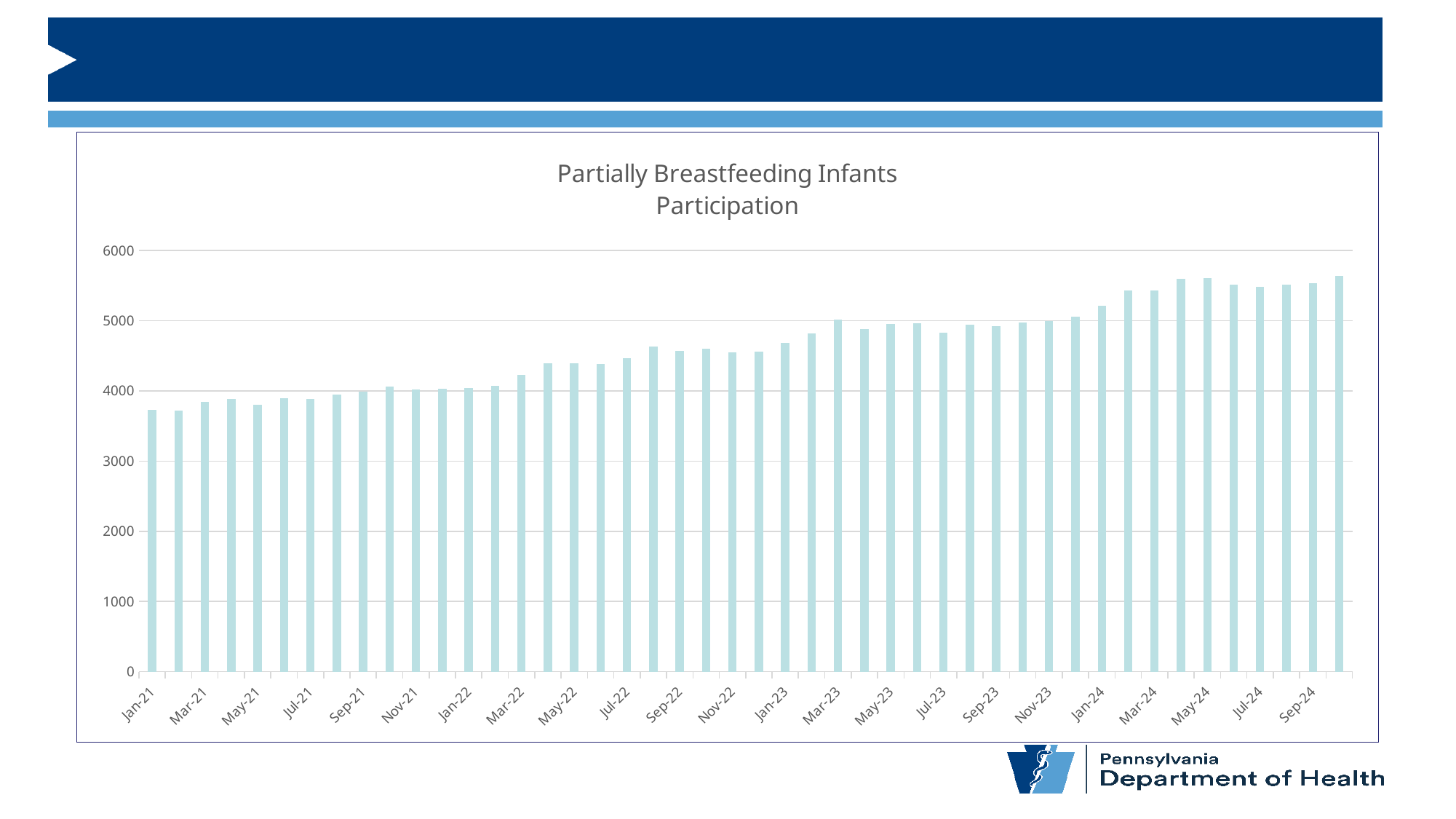
Is the value for Sep-22 greater or less than 4000? greater What kind of chart is shown on the slide? bar chart Is the value for Sep-24 greater or less than 5000? greater Is the value for Jan-21 greater or less than 4000? less What is the title of the chart? Partially Breastfeeding Infants Participation Which is larger, the value for Jan-21 or the value for Jan-24? Jan-24 Which is larger, the value for Mar-22 or the value for Mar-23? Mar-23 Do the values generally rise or fall from Jan-21 to Sep-24? rise